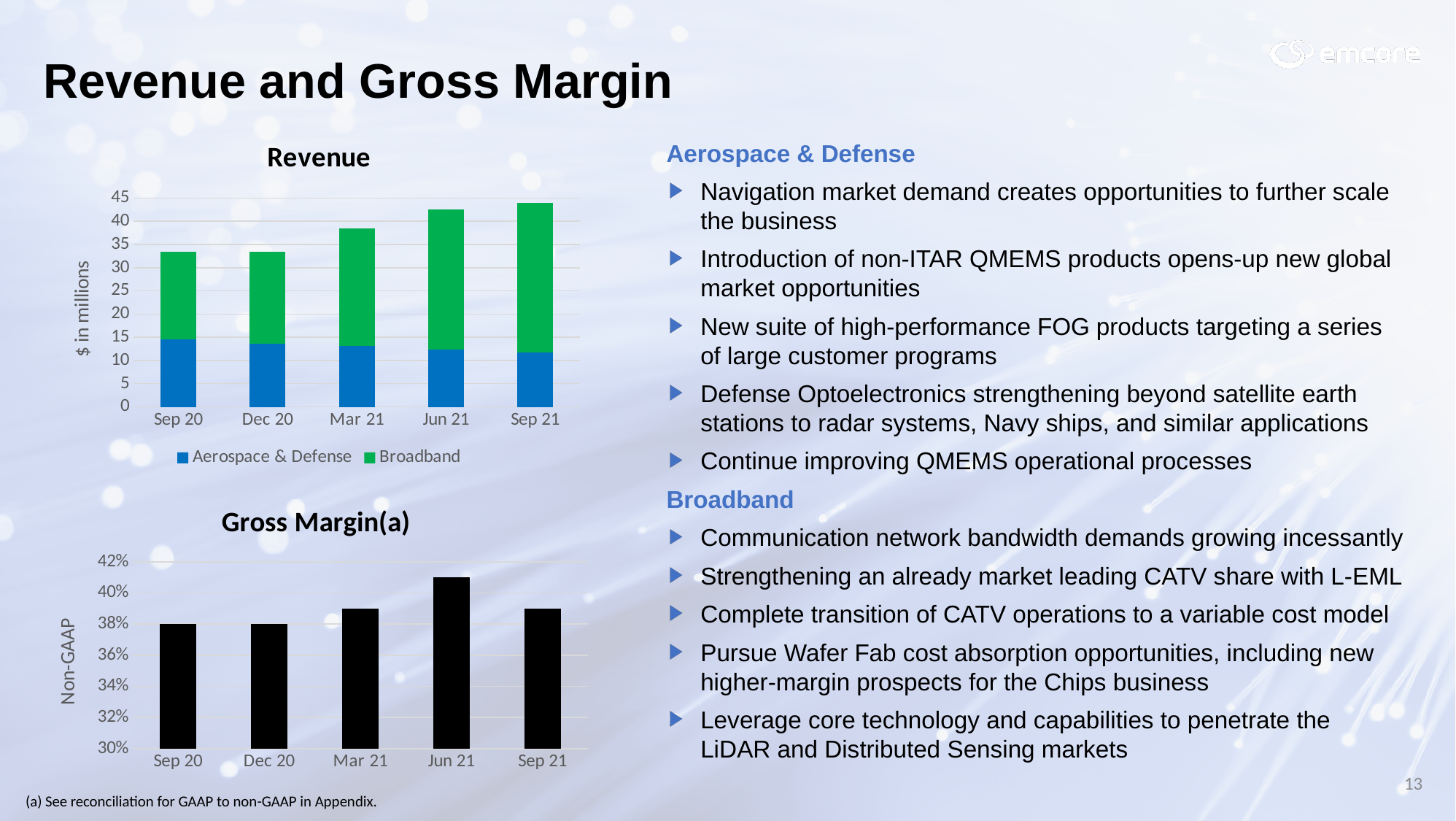
In the Revenue chart, does total revenue generally rise or fall from Sep 20 to Sep 21? rise What is the y-axis label of the Gross Margin(a) chart? Non-GAAP How many periods are shown on the x axis of the Revenue chart? 5 In the Gross Margin(a) chart, is the value for Jun 21 greater or less than 40%? greater How many series does the legend of the Revenue chart list? 2 In the Revenue chart, is the total revenue for Sep 20 greater or less than 35? less In the Revenue chart, which period has the largest Broadband segment? Sep 21 In the Revenue chart, which period has the highest total revenue? Sep 21 In the Revenue chart, is the total revenue for Sep 21 greater or less than 40? greater In the Gross Margin(a) chart, which period has the highest gross margin? Jun 21 What kind of chart is the Revenue chart? stacked bar chart